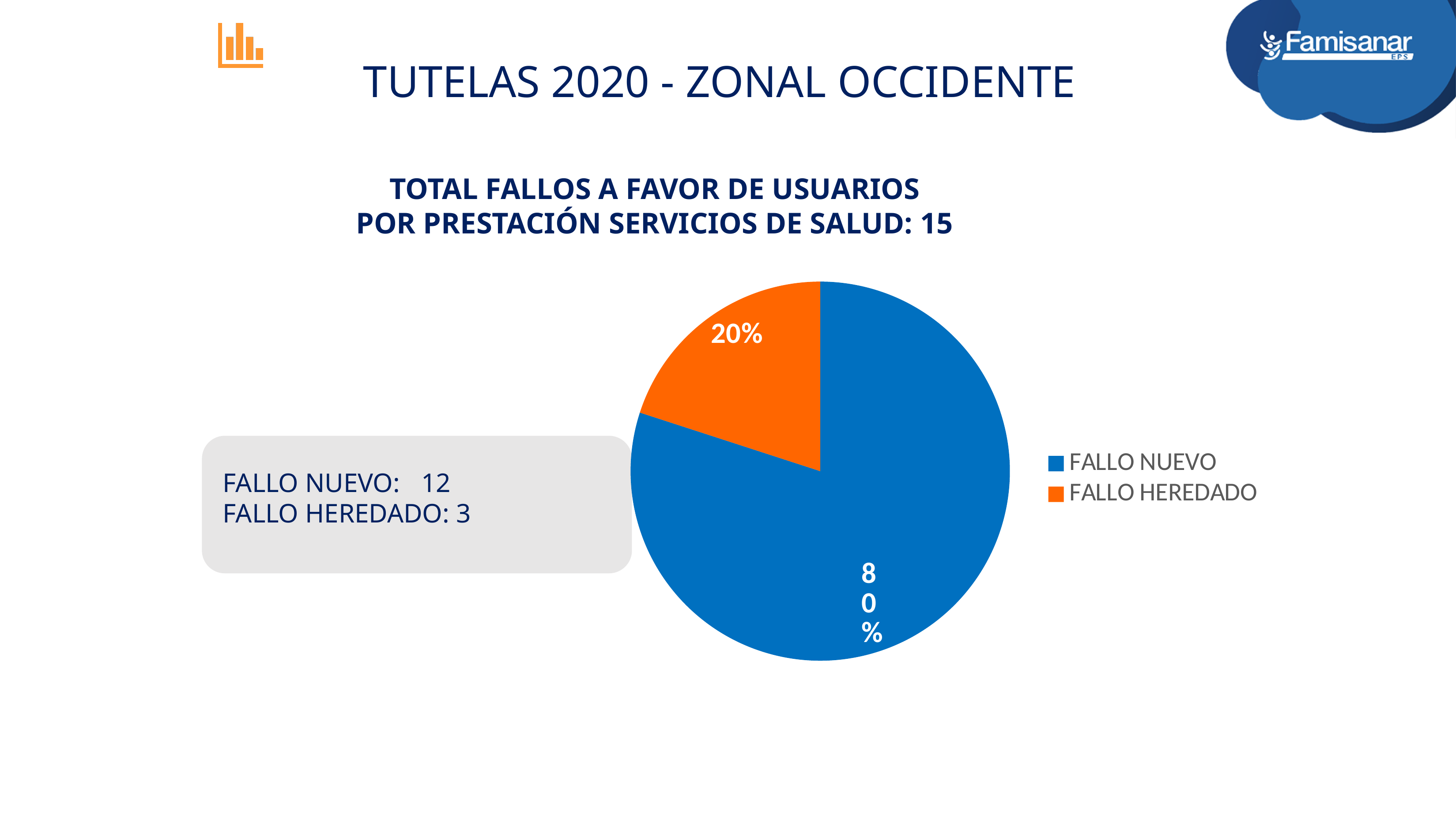
What is the difference in percentage points between the FALLO NUEVO and FALLO HEREDADO slices? 60 percentage points How many entries does the legend list? 2 What percentage share does the FALLO HEREDADO slice have in the pie chart? 20% Which category has the smallest slice in the pie chart? FALLO HEREDADO How many slices does the pie chart have? 2 Which is larger, the FALLO NUEVO slice or the FALLO HEREDADO slice? FALLO NUEVO What colour is the FALLO HEREDADO slice in the pie chart? orange What percentage share does the FALLO NUEVO slice have in the pie chart? 80% What colour is the FALLO NUEVO slice in the pie chart? blue Which category has the largest slice in the pie chart? FALLO NUEVO What type of chart is shown on the slide? pie chart